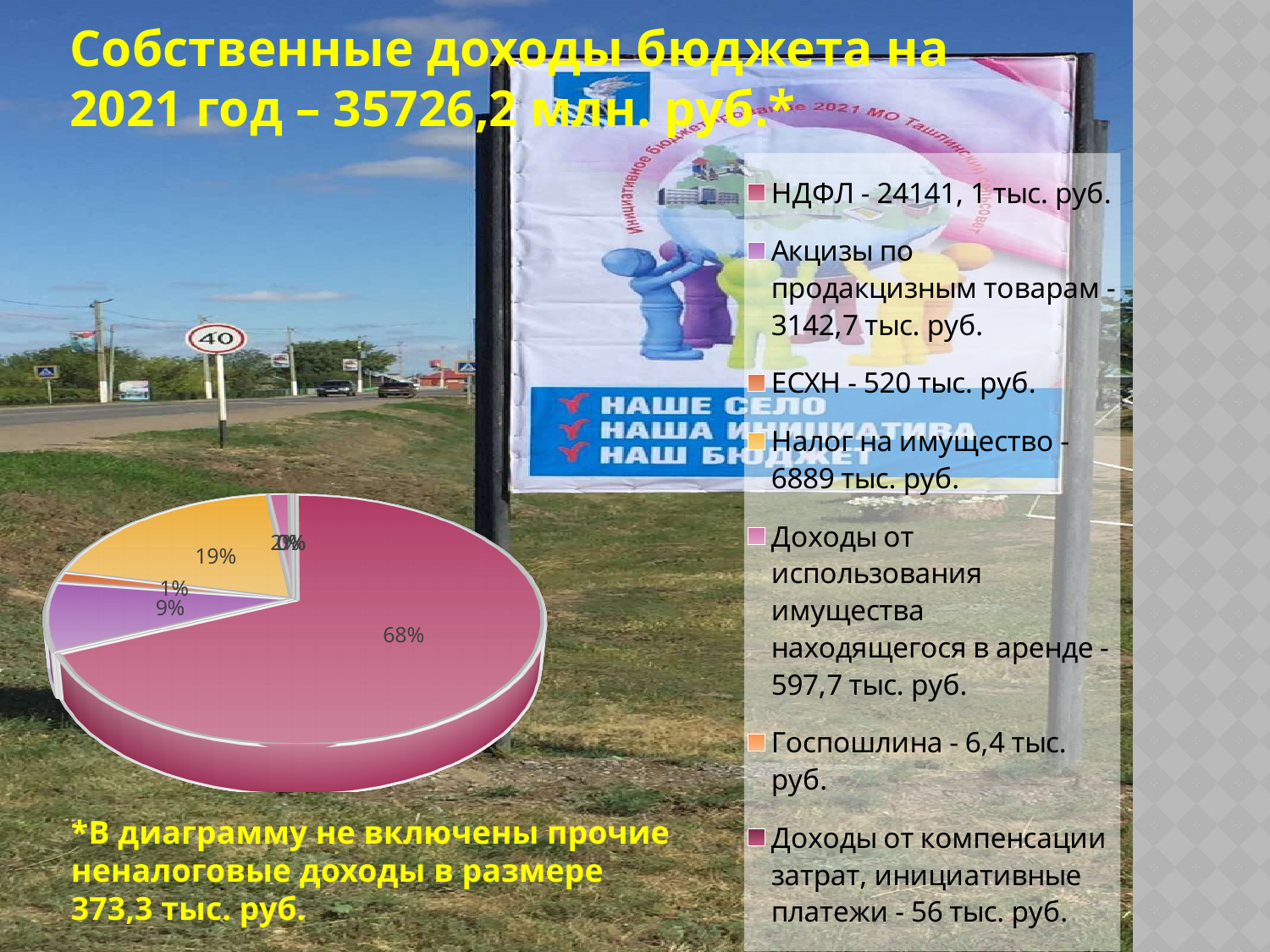
Which slice is larger: Налог на имущество or Акцизы по продакцизным товарам? Налог на имущество According to the legend, what is the value for Госпошлина? 6,4 тыс. руб. How many entries does the chart legend list? 7 What share of the pie do Акцизы по продакцизным товарам take? 9% Which category has the largest slice of the pie? НДФЛ According to the legend, what is the value for ЕСХН? 520 тыс. руб. What is the difference in percentage points between the НДФЛ slice and the Налог на имущество slice? 49% What kind of chart is shown on the slide? pie chart What share of the pie does НДФЛ take? 68% What share of the pie does Налог на имущество take? 19% According to the legend, what is the value for Налог на имущество? 6889 тыс. руб.